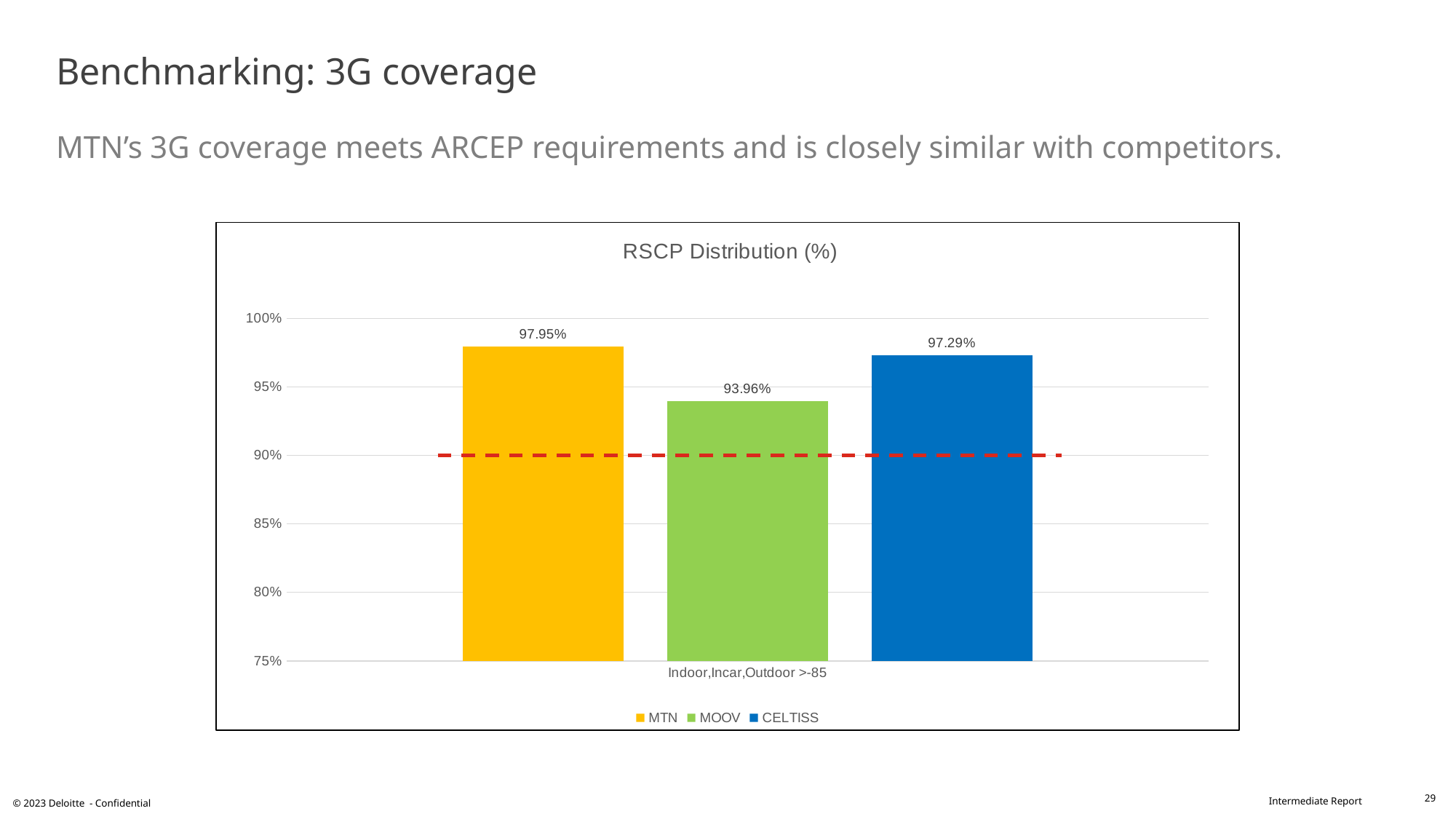
What is the RSCP Distribution value for MOOV? 93.96% What kind of chart is shown on the slide? Bar chart What is the difference between the MTN and MOOV values? 3.99% What is the difference between the MTN and CELTISS values? 0.66% How many series does the legend list? 3 What is the RSCP Distribution value for MTN? 97.95% Which operator has the lowest RSCP Distribution value? MOOV Which is larger, the value for MOOV or the value for CELTISS? CELTISS Is the value for MOOV greater or less than 95%? less What is the RSCP Distribution value for CELTISS? 97.29% What is the title of the chart? RSCP Distribution (%) Which operator has the highest RSCP Distribution value? MTN